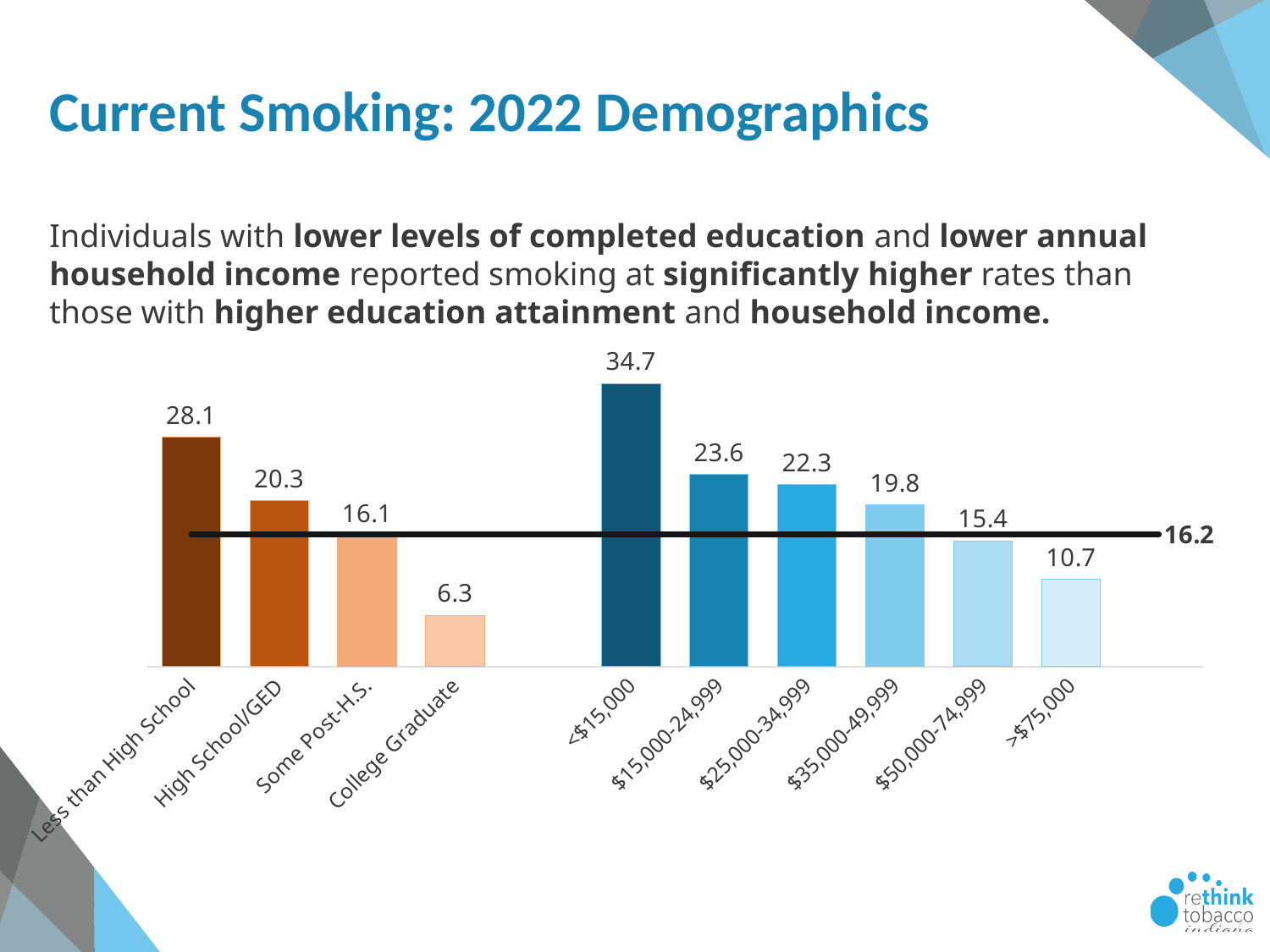
Which category has the lowest value on the chart? College Graduate What is the difference between the Less than High School value and the College Graduate value? 21.8 How many bars are shown on the chart in total? 10 Which category has the highest value on the chart? <$15,000 What is the current smoking rate for the Less than High School category? 28.1 Which is larger, the value for High School/GED or the value for $15,000-24,999? $15,000-24,999 What is the value shown for the $35,000-49,999 income category? 19.8 What is the value shown for the <$15,000 income category? 34.7 What type of chart is shown on the slide? Bar chart What value is marked by the horizontal black line across the chart? 16.2 Do the values rise or fall as income increases from <$15,000 to >$75,000? Fall What is the difference between the <$15,000 value and the >$75,000 value? 24.0